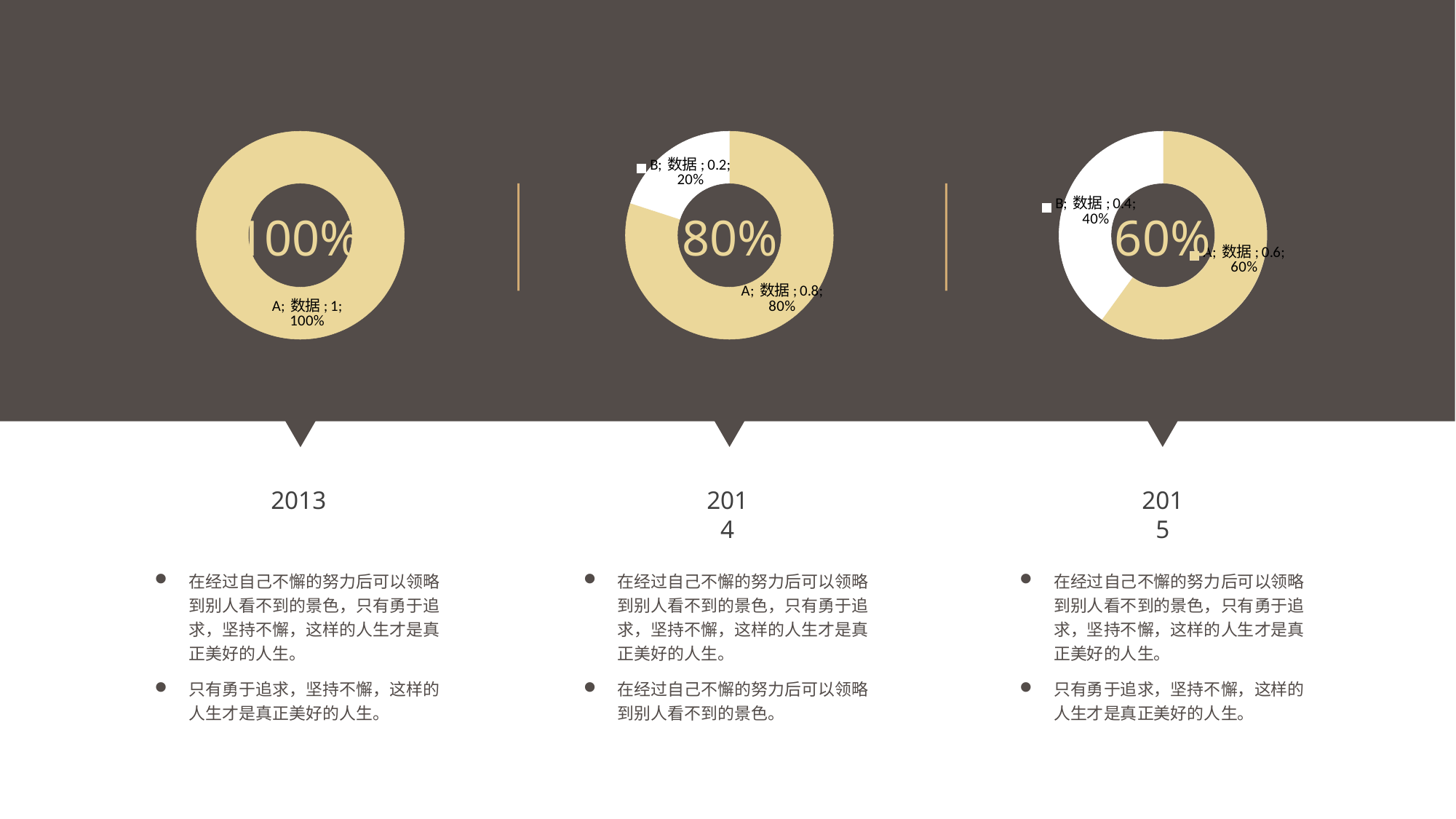
In the middle chart (above 2014), what share of the doughnut does slice B take? 20% In the right chart (above 2015), which slice is larger, A or B? A In the middle chart (above 2014), which slice is the smallest? B In the middle chart (above 2014), what share of the doughnut does slice A take? 80% In the right chart (above 2015), what share of the doughnut does slice B take? 40% In the right chart (above 2015), what is the data label value for slice B? 0.4 What kind of chart is the middle chart on the slide? doughnut chart In the middle chart (above 2014), what is the data label value for slice A? 0.8 In the right chart (above 2015), what is the difference between the shares of slice A and slice B? 20% How many slices does the right chart (above 2015) have? 2